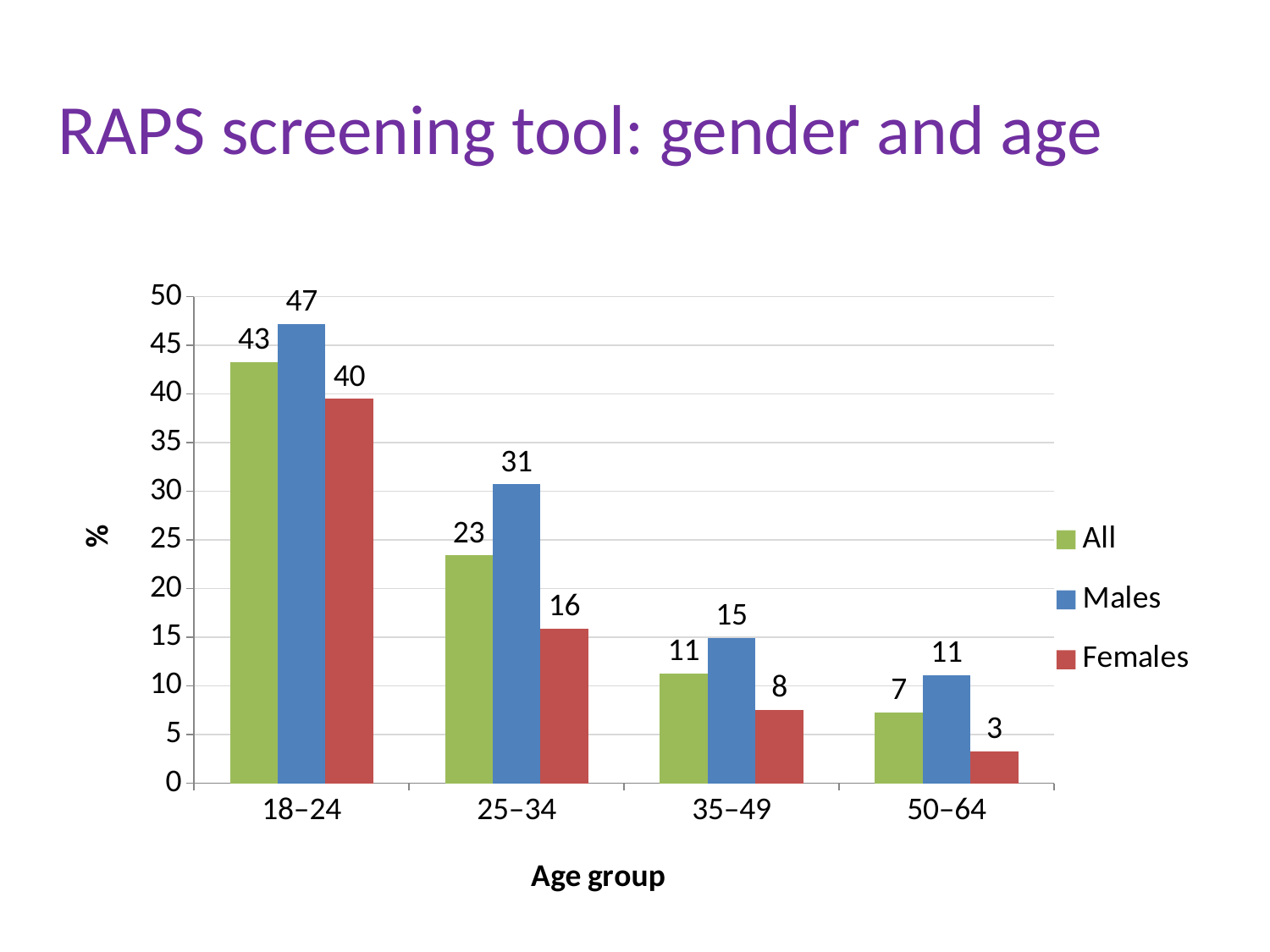
How many age groups are shown on the x axis? 4 What is the value for Females in the 50–64 age group? 3 What kind of chart is shown on the slide? Bar chart What is the value for Males in the 18–24 age group? 47 What is the value for All in the 25–34 age group? 23 How many series does the legend list? 3 What is the difference between the Males and Females values in the 25–34 age group? 15 What is the label of the x axis? Age group Which age group has the lowest value for Males? 50–64 Do the values for Males rise or fall as age group increases along the x axis? Fall Which is larger in the 35–49 age group, the value for All or the value for Females? All Which age group has the highest value for Females? 18–24